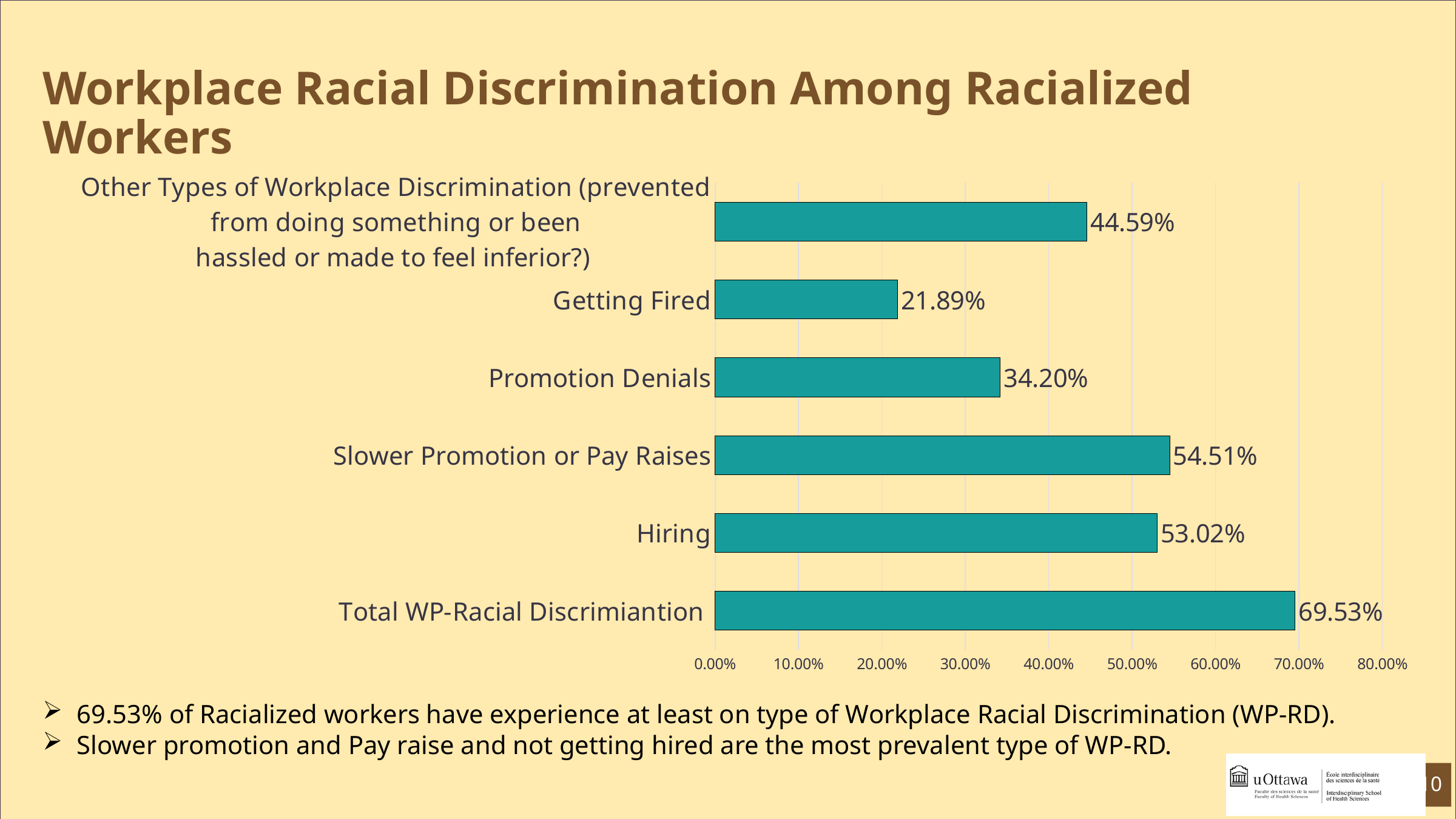
Which category has the lowest value? Getting Fired What is the value for Getting Fired? 21.89% What is the value for Hiring? 53.02% Which is larger, the value for Hiring or the value for Promotion Denials? Hiring What kind of chart is shown on the slide? Bar chart What is the difference between Slower Promotion or Pay Raises and Hiring? 1.49% Is the value for Promotion Denials greater or less than 30.00%? greater How many categories are shown in the chart? 6 What is the value for Promotion Denials? 34.20% What is the value for Slower Promotion or Pay Raises? 54.51% What is the difference between Total WP-Racial Discrimiantion and Getting Fired? 47.64% Which category has the highest value? Total WP-Racial Discrimiantion